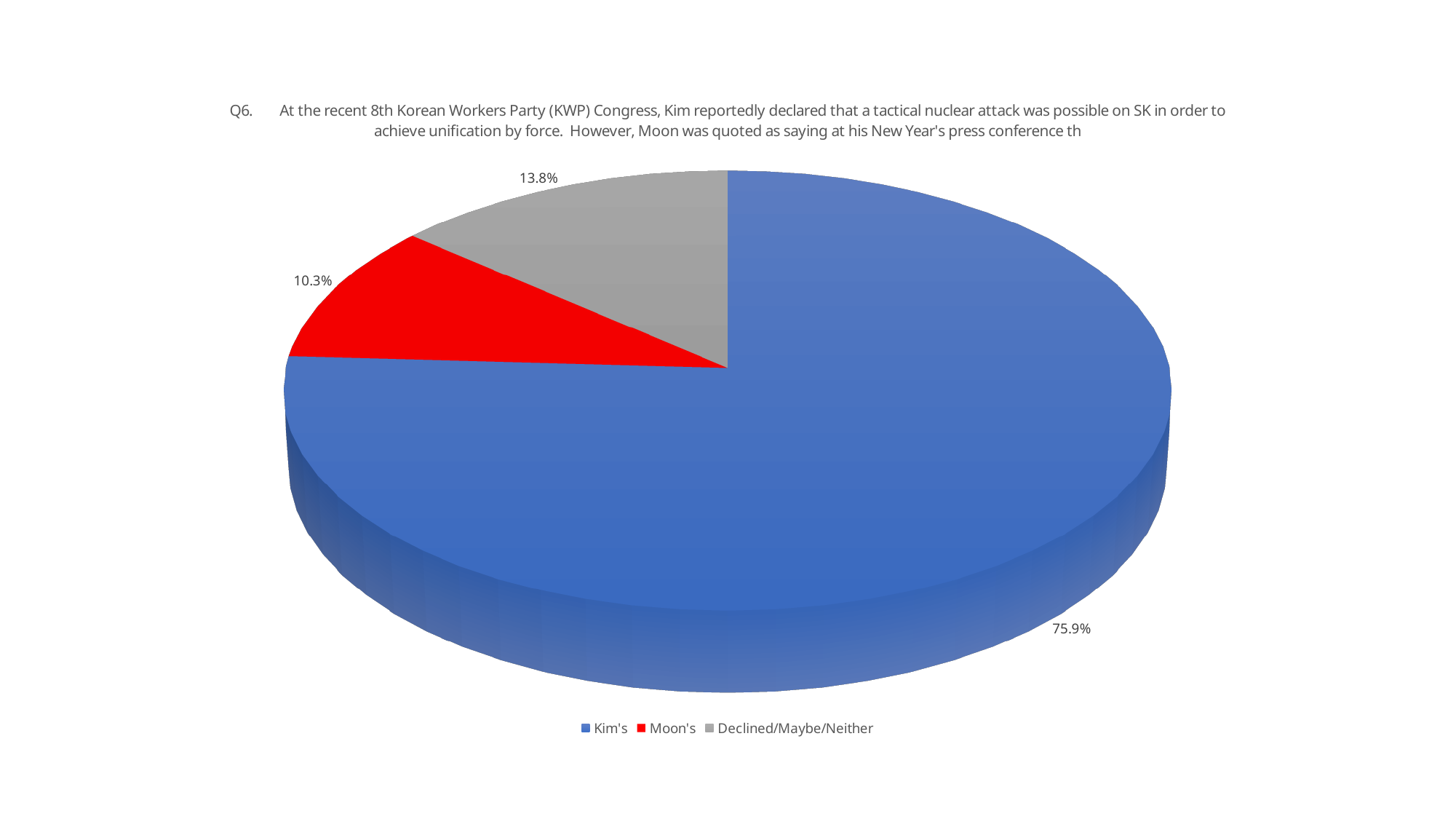
What is the difference in percentage points between the Declined/Maybe/Neither slice and the Moon's slice? 3.5 What kind of chart is shown on the slide? Pie chart What colour is the slice for Moon's? Red What percentage of the pie is labelled for Moon's? 10.3% Which category has the largest slice of the pie? Kim's What colour is the slice for Kim's? Blue How many categories does the legend list? 3 What percentage of the pie is labelled for Declined/Maybe/Neither? 13.8% Which is larger, the slice for Moon's or the slice for Declined/Maybe/Neither? Declined/Maybe/Neither What percentage of the pie is labelled for Kim's? 75.9% What is the difference in percentage points between the Kim's slice and the Declined/Maybe/Neither slice? 62.1 Which category has the smallest slice of the pie? Moon's